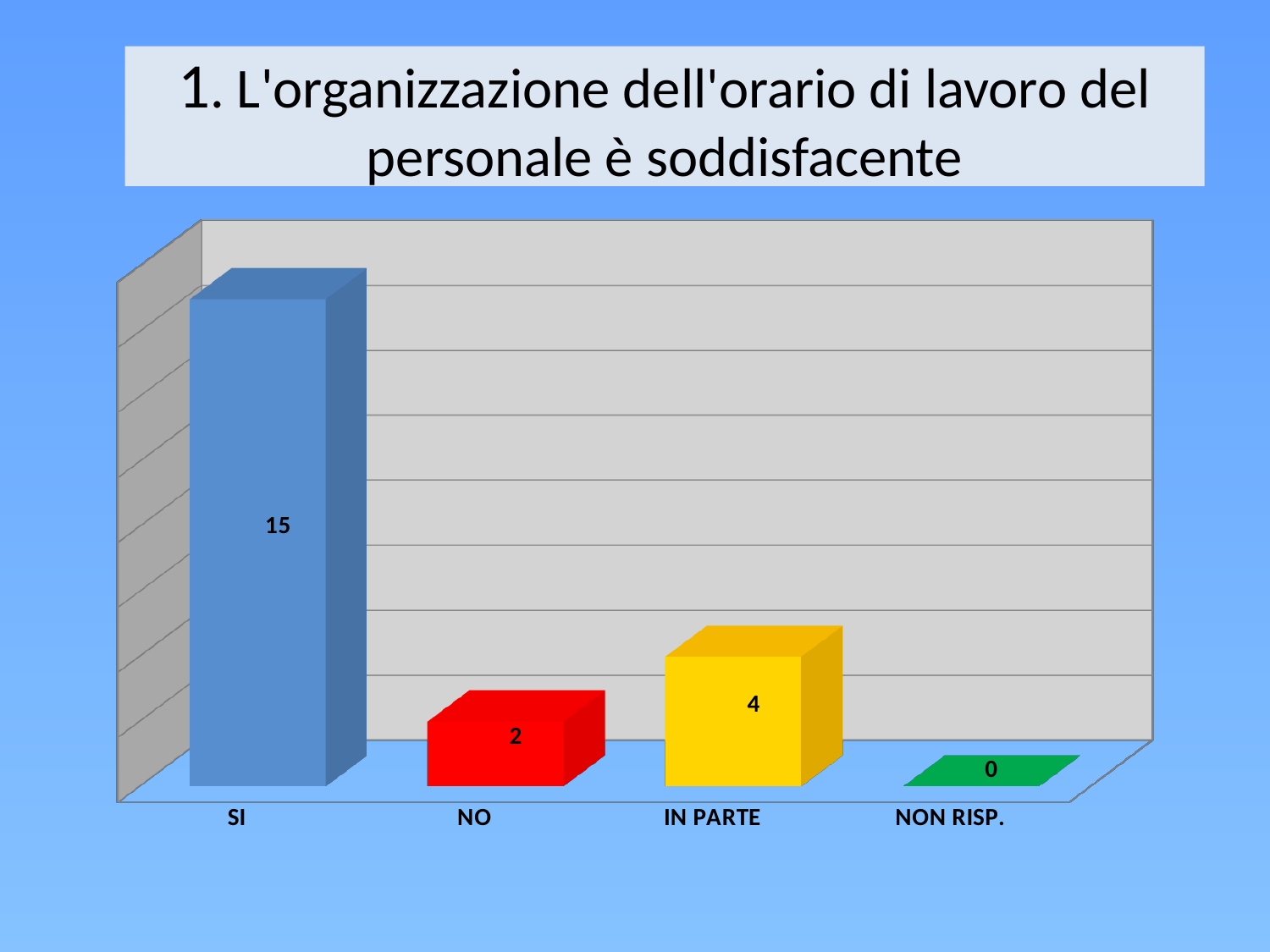
What is the value for IN PARTE? 4 What is the difference between the values for SI and IN PARTE? 11 Which category has the lowest value? NON RISP. What is the value for NON RISP.? 0 What is the value for NO? 2 What colour is the bar for SI? blue How many categories are shown on the x axis? 4 What is the value for SI? 15 What kind of chart is shown on the slide? bar chart What is the difference between the values for IN PARTE and NO? 2 Which category has the highest value? SI Which is larger, the value for NO or the value for IN PARTE? IN PARTE